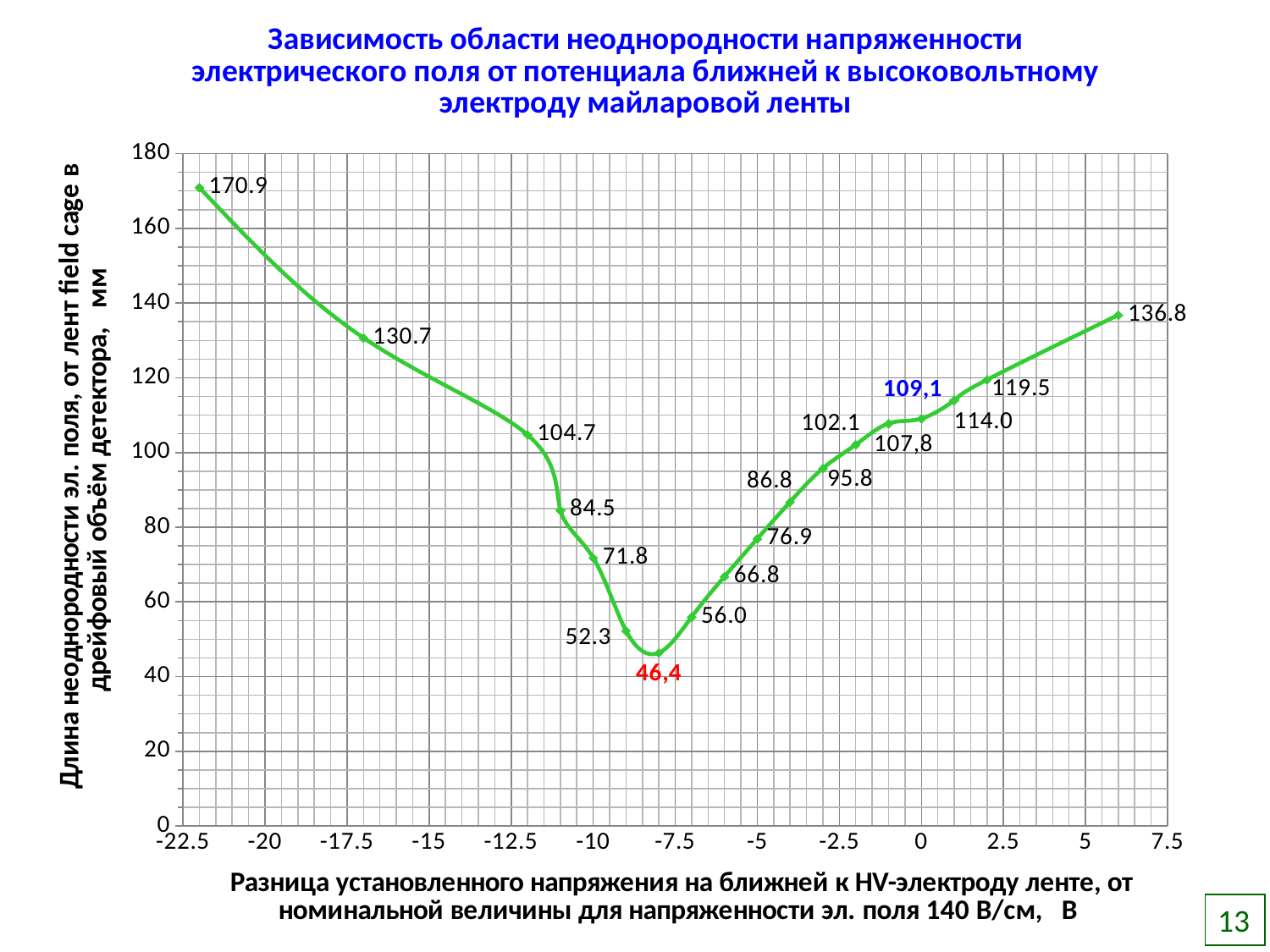
Which is larger, the value labelled 130.7 or the value labelled 136.8? 136.8 What value is shown by the blue data label on the chart? 109,1 What is the value of the leftmost data point on the chart? 170.9 What is the maximum value shown on the y axis? 180 What is the difference between the highest and lowest plotted values? 124.5 Do the values rise or fall along the x axis from the leftmost point to the lowest point? fall What kind of chart is shown on the slide? line chart What is the difference between the rightmost point (136.8) and the point labelled 130.7? 6.1 What is the lowest value plotted on the chart? 46,4 How many data points are plotted on the chart? 18 What is the highest value plotted on the chart? 170.9 What is the value of the rightmost data point on the chart? 136.8